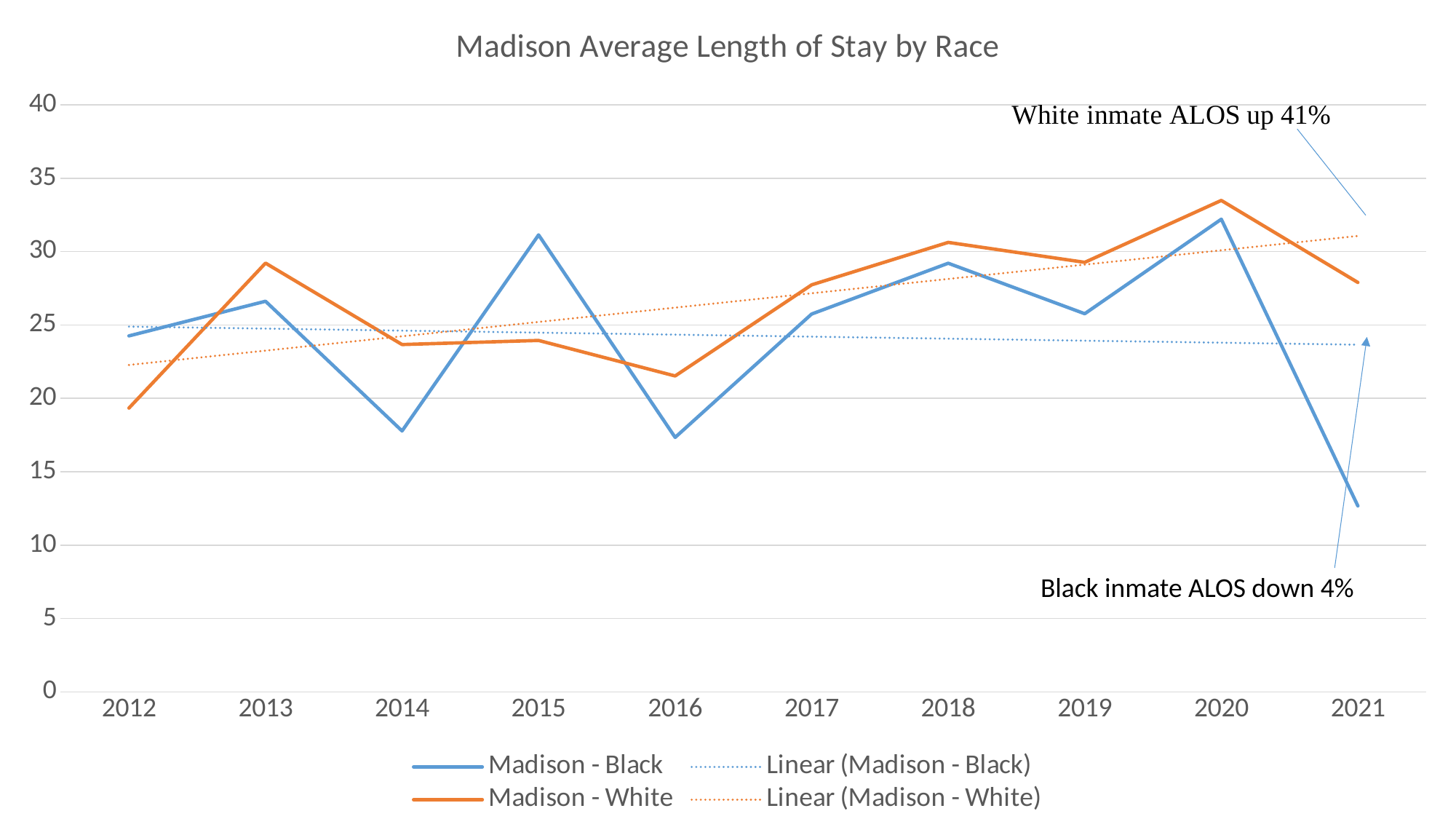
Is the Madison - Black value for 2016 greater or less than 20? less In which year is the Madison - White value lowest? 2012 What type of chart is shown on the slide? Line chart In which year is the Madison - Black value lowest? 2021 How many entries does the legend list? 4 Is the Madison - White value for 2020 greater or less than 30? greater How many years are shown on the x axis? 10 According to the annotation on the chart, by what percentage did White inmate ALOS go up? 41% In 2021, which series has the larger value, Madison - Black or Madison - White? Madison - White What is the title of the chart? Madison Average Length of Stay by Race In which year is the Madison - White value highest? 2020 Is the Madison - Black value for 2021 greater or less than 15? less